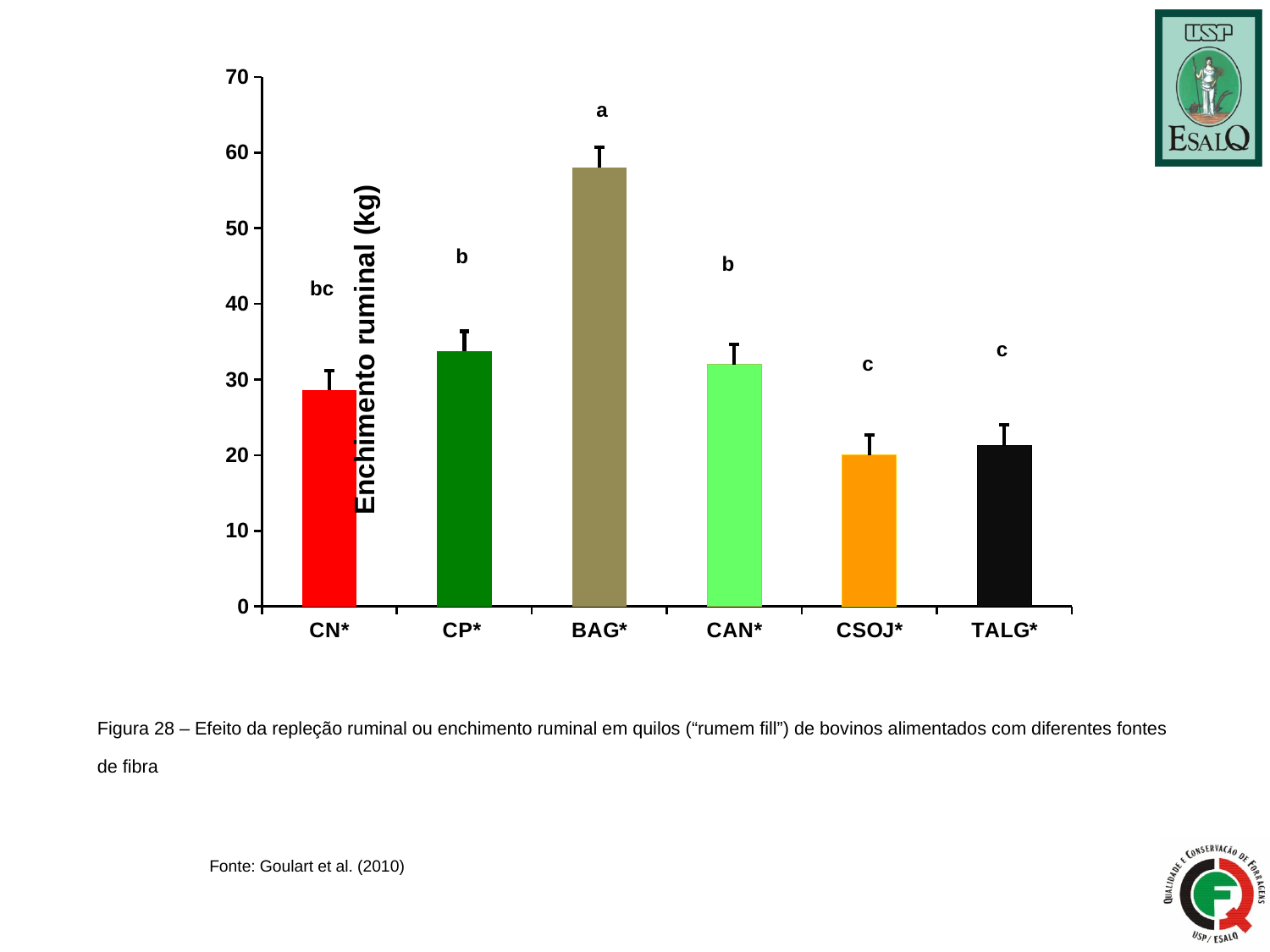
What is the title of the y axis of the chart? Enchimento ruminal (kg) What letter is printed above the BAG* bar? a Is the value for CP* greater or less than 30? greater Which category has the highest value in the chart? BAG* Which is larger, the value for BAG* or the value for CP*? BAG* Is the value for TALG* greater or less than 30? less Is the value for BAG* greater or less than 60? less Which is larger, the value for CP* or the value for CSOJ*? CP* How many categories are shown on the x axis of the chart? 6 What kind of chart is shown on the slide? bar chart